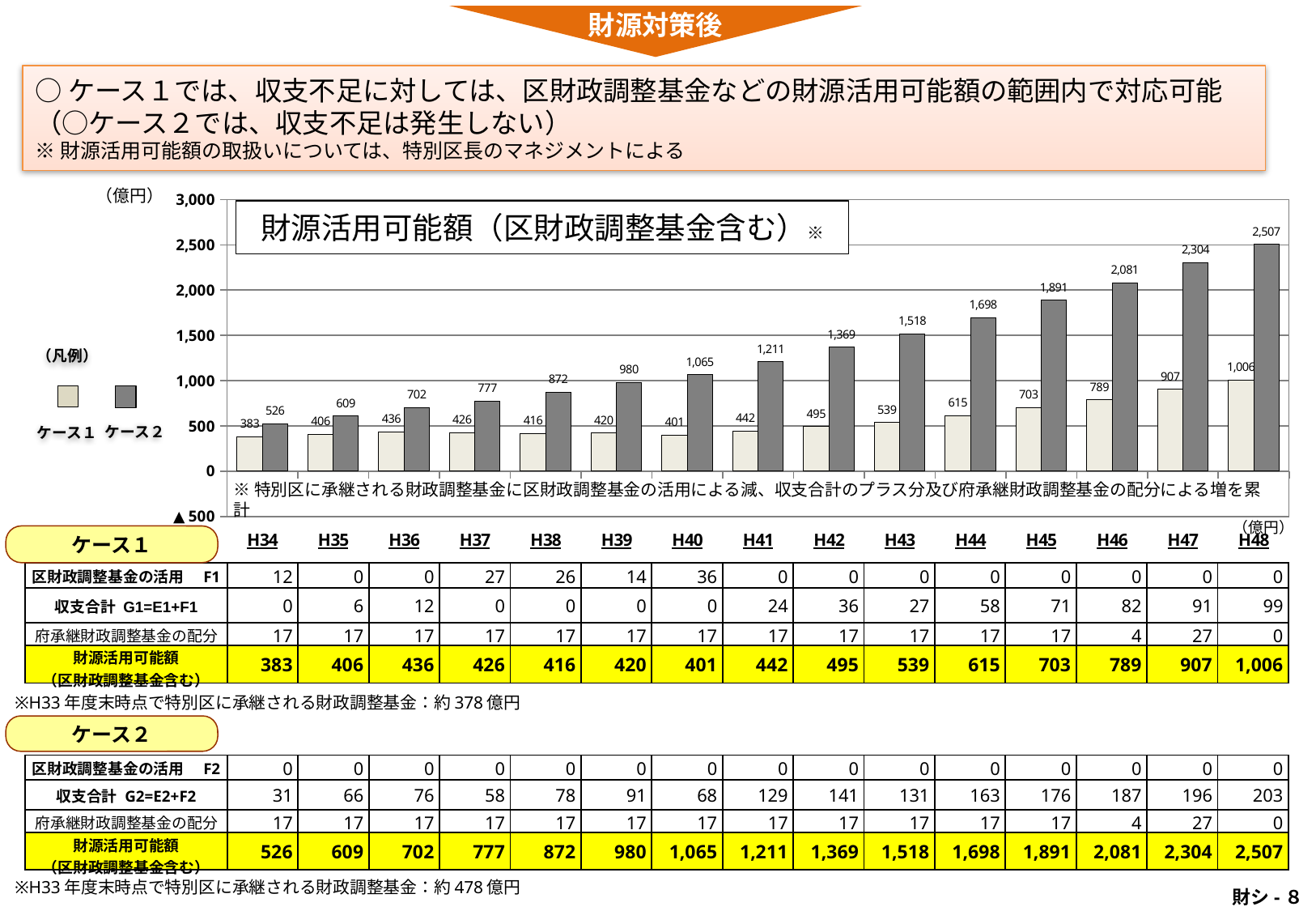
How many series does the legend list? 2 What kind of chart is shown on the slide? bar chart Which is larger in H38: the ケース1 value or the ケース2 value? ケース2 In which year is the ケース1 value lowest? H34 In which year is the ケース2 value highest? H48 What is the difference between ケース2 and ケース1 in H48? 1,501 What is the value for ケース2 in H48? 2,507 Do the ケース2 values rise or fall from H34 to H48? rise What is the value for ケース2 in H42? 1,369 What is the title of the chart? 財源活用可能額（区財政調整基金含む） What is the value for ケース1 in H40? 401 How many fiscal years (categories) are plotted on the x axis? 15